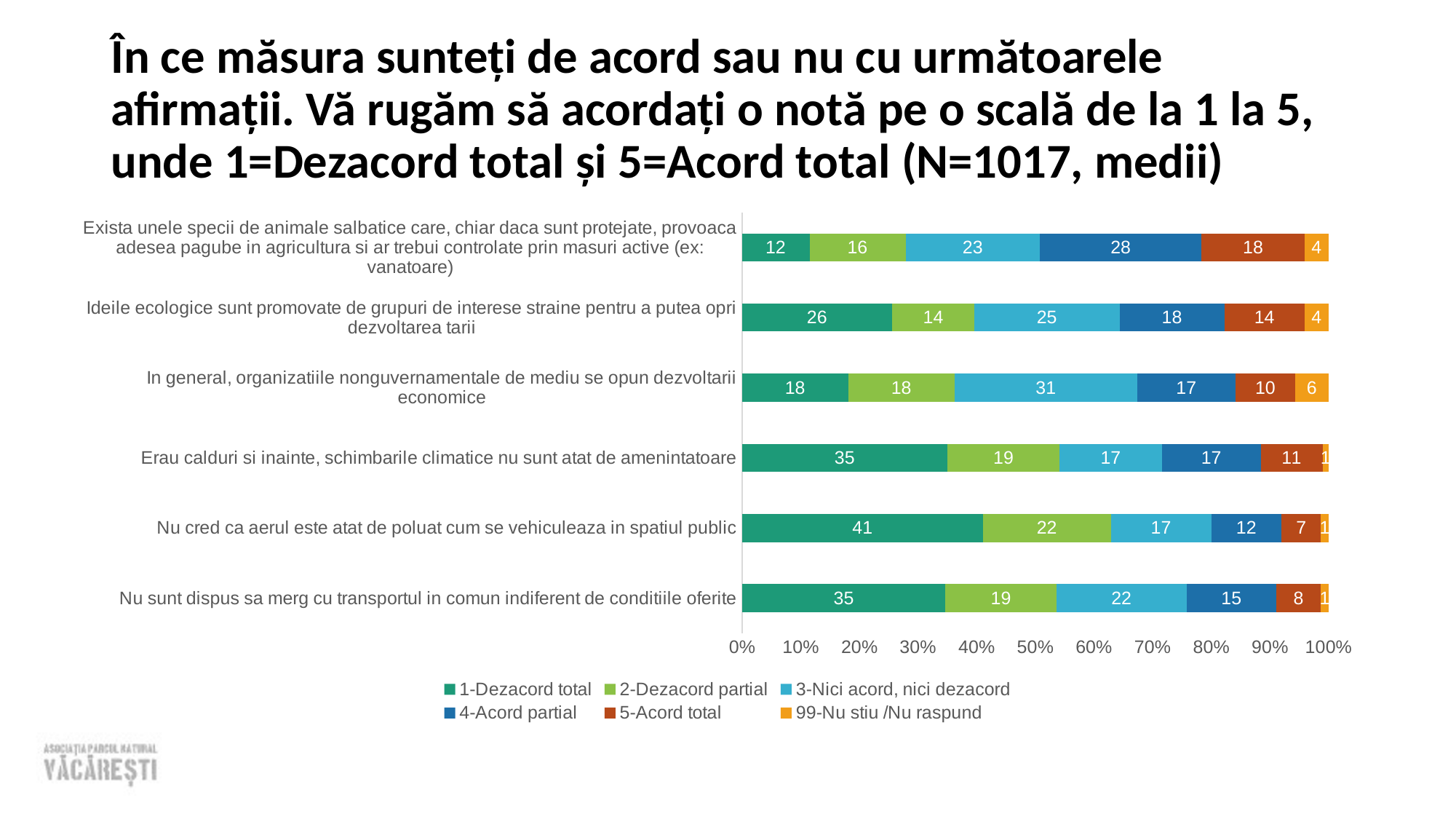
Which statement has the lowest value for 1-Dezacord total? Exista unele specii de animale salbatice care, chiar daca sunt protejate, provoaca adesea pagube in agricultura si ar trebui controlate prin masuri active (ex: vanatoare) What is the value of 1-Dezacord total for the statement 'Nu cred ca aerul este atat de poluat cum se vehiculeaza in spatiul public'? 41 What kind of chart is shown on the slide? Stacked bar chart What is the value of 5-Acord total for the statement 'Exista unele specii de animale salbatice care, chiar daca sunt protejate, provoaca adesea pagube in agricultura...'? 18 Which statement has the larger 4-Acord partial value: 'Exista unele specii de animale salbatice...' or 'Ideile ecologice sunt promovate de grupuri de interese straine...'? Exista unele specii de animale salbatice care, chiar daca sunt protejate, provoaca adesea pagube in agricultura si ar trebui controlate prin masuri active (ex: vanatoare) What is the difference between the 3-Nici acord, nici dezacord values for 'In general, organizatiile nonguvernamentale de mediu se opun dezvoltarii economice' and 'Erau calduri si inainte, schimbarile climatice nu sunt atat de amenintatoare'? 14 For the statement 'Exista unele specii de animale salbatice...', which response category has the largest segment? 4-Acord partial What is the value of 99-Nu stiu /Nu raspund for the statement 'In general, organizatiile nonguvernamentale de mediu se opun dezvoltarii economice'? 6 How many series does the legend list? 6 How many statements (categories) are plotted on the chart? 6 Which statement has the highest value for 1-Dezacord total? Nu cred ca aerul este atat de poluat cum se vehiculeaza in spatiul public Which series does the dark green colour in the legend represent? 1-Dezacord total